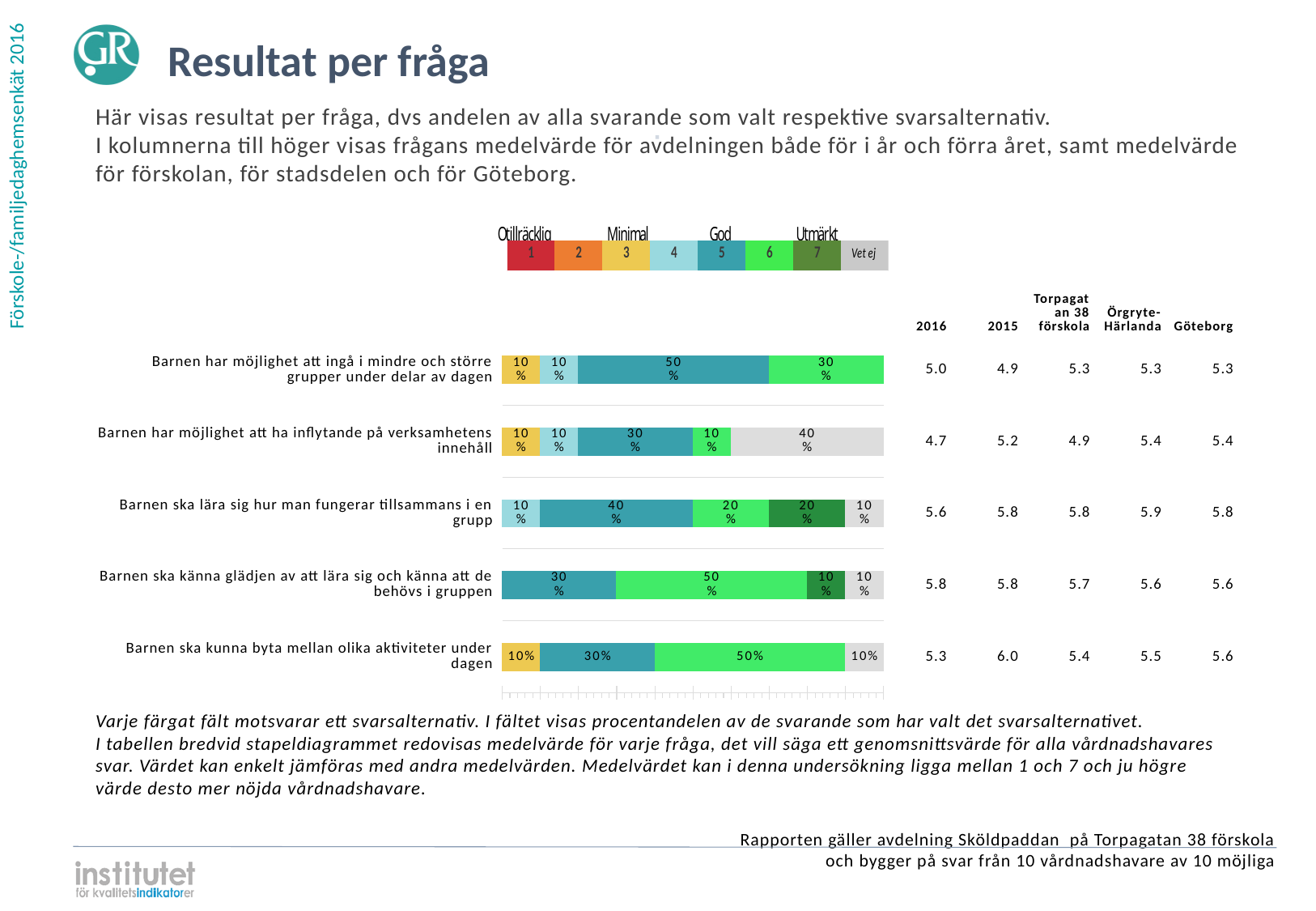
For 'Barnen ska lära sig hur man fungerar tillsammans i en grupp', which is larger: the share choosing answer 5 or the share choosing answer 6? Answer 5 What percentage of respondents chose answer 5 (God, teal) for 'Barnen har möjlighet att ingå i mindre och större grupper under delar av dagen'? 50% What kind of chart is used to show the results per question? Stacked bar chart How many questions (categories) are shown as bars in the chart? 5 How many answer alternatives does the colour legend above the chart list? 8 For 'Barnen ska känna glädjen av att lära sig och känna att de behövs i gruppen', what is the difference between the share choosing answer 6 and the share choosing answer 5? 20% What percentage of respondents chose answer 6 (bright green) for 'Barnen ska kunna byta mellan olika aktiviteter under dagen'? 50% Which question has the largest share of 'Vet ej' answers? Barnen har möjlighet att ha inflytande på verksamhetens innehåll What is the 2015 mean value shown for 'Barnen ska kunna byta mellan olika aktiviteter under dagen'? 6.0 What is the 2016 mean value shown for 'Barnen ska känna glädjen av att lära sig och känna att de behövs i gruppen'? 5.8 What percentage of respondents answered 'Vet ej' for 'Barnen har möjlighet att ha inflytande på verksamhetens innehåll'? 40% What percentage of respondents chose answer 7 (dark green) for 'Barnen ska lära sig hur man fungerar tillsammans i en grupp'? 20%